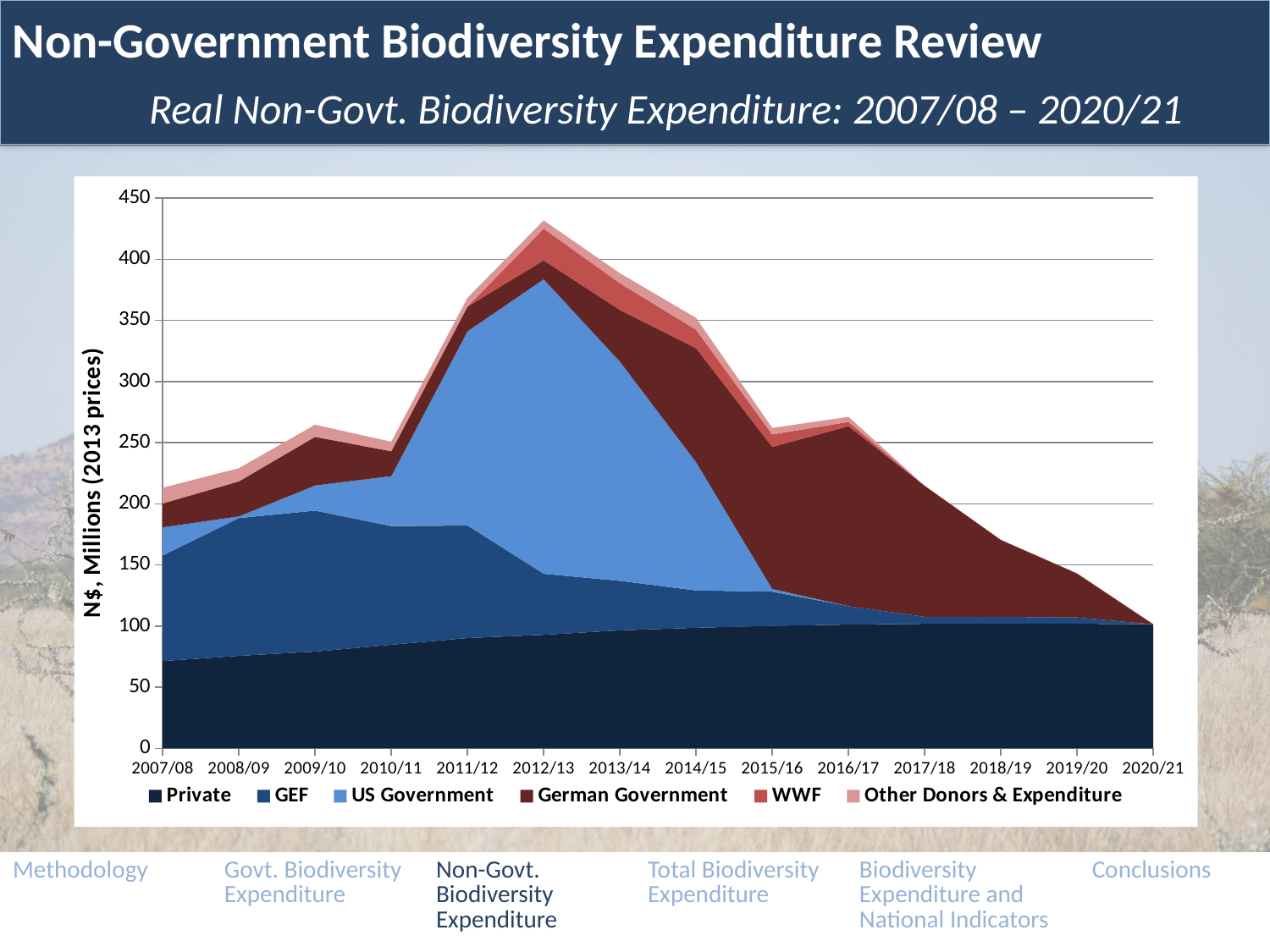
Does total expenditure rise or fall from 2012/13 to 2020/21? fall What kind of chart is shown on the slide? Stacked area chart Is the Private expenditure in 2007/08 greater or less than 100? less How many series does the legend list? 6 What is the label on the vertical axis? N$, Millions (2013 prices) Is the total expenditure in 2012/13 greater or less than 400? greater Which year has the larger total expenditure, 2012/13 or 2016/17? 2012/13 In which year is total non-government biodiversity expenditure lowest? 2020/21 How many financial years are shown along the x axis? 14 Which series is listed first in the legend? Private Is the total expenditure in 2020/21 greater or less than 150? less In which year does total non-government biodiversity expenditure reach its highest point? 2012/13